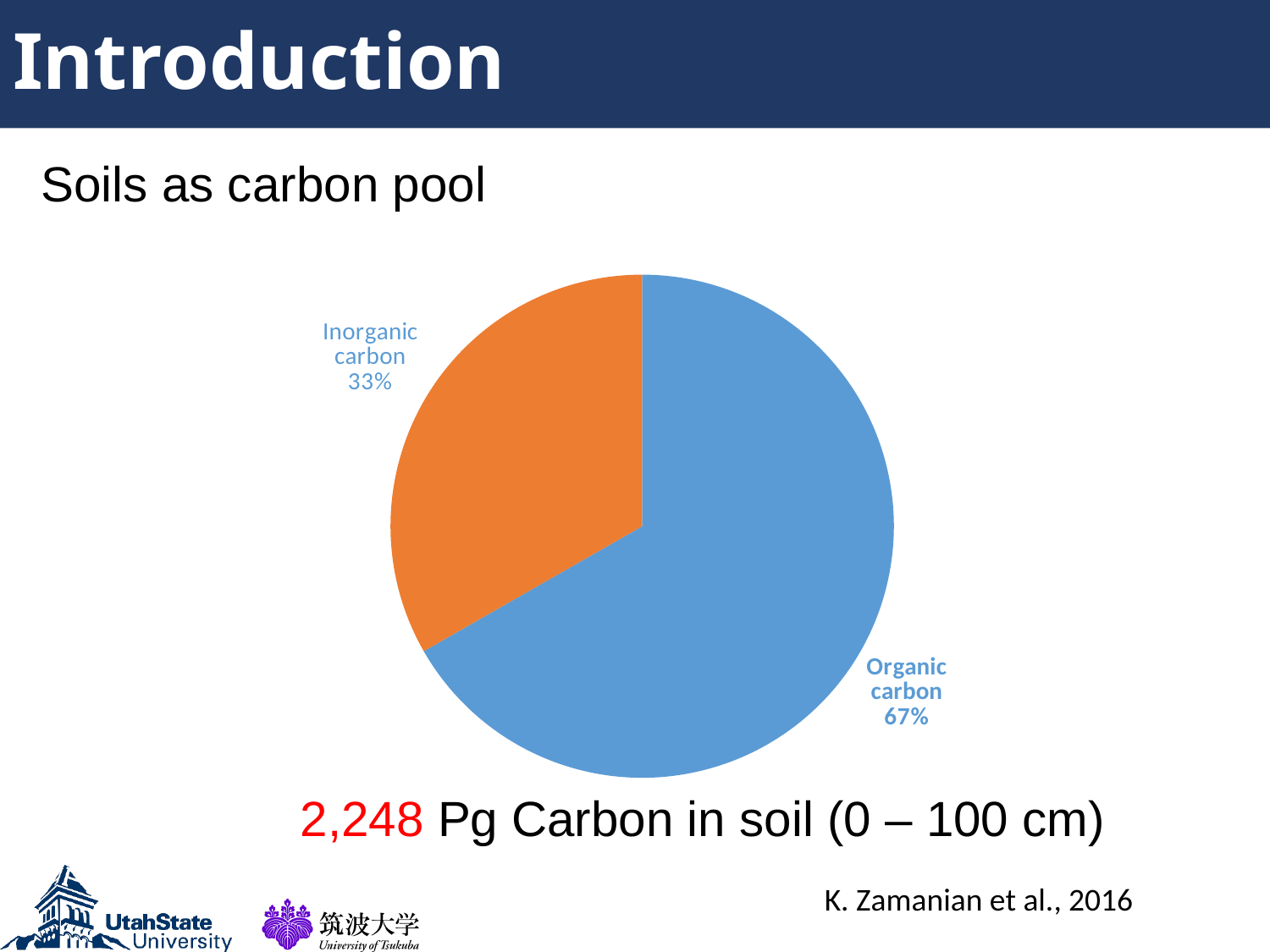
Which slice of the pie is the largest? Organic carbon What colour is the Inorganic carbon slice? orange What is the difference in percentage points between the Organic carbon and Inorganic carbon slices? 34 What colour is the Organic carbon slice? blue Which is larger, the Organic carbon slice or the Inorganic carbon slice? Organic carbon How many slices does the pie chart have? 2 What kind of chart is shown on the slide? pie chart What share of the pie does Organic carbon represent? 67% What share of the pie does Inorganic carbon represent? 33% Is the share for Inorganic carbon greater or less than 50%? less Which slice of the pie is the smallest? Inorganic carbon